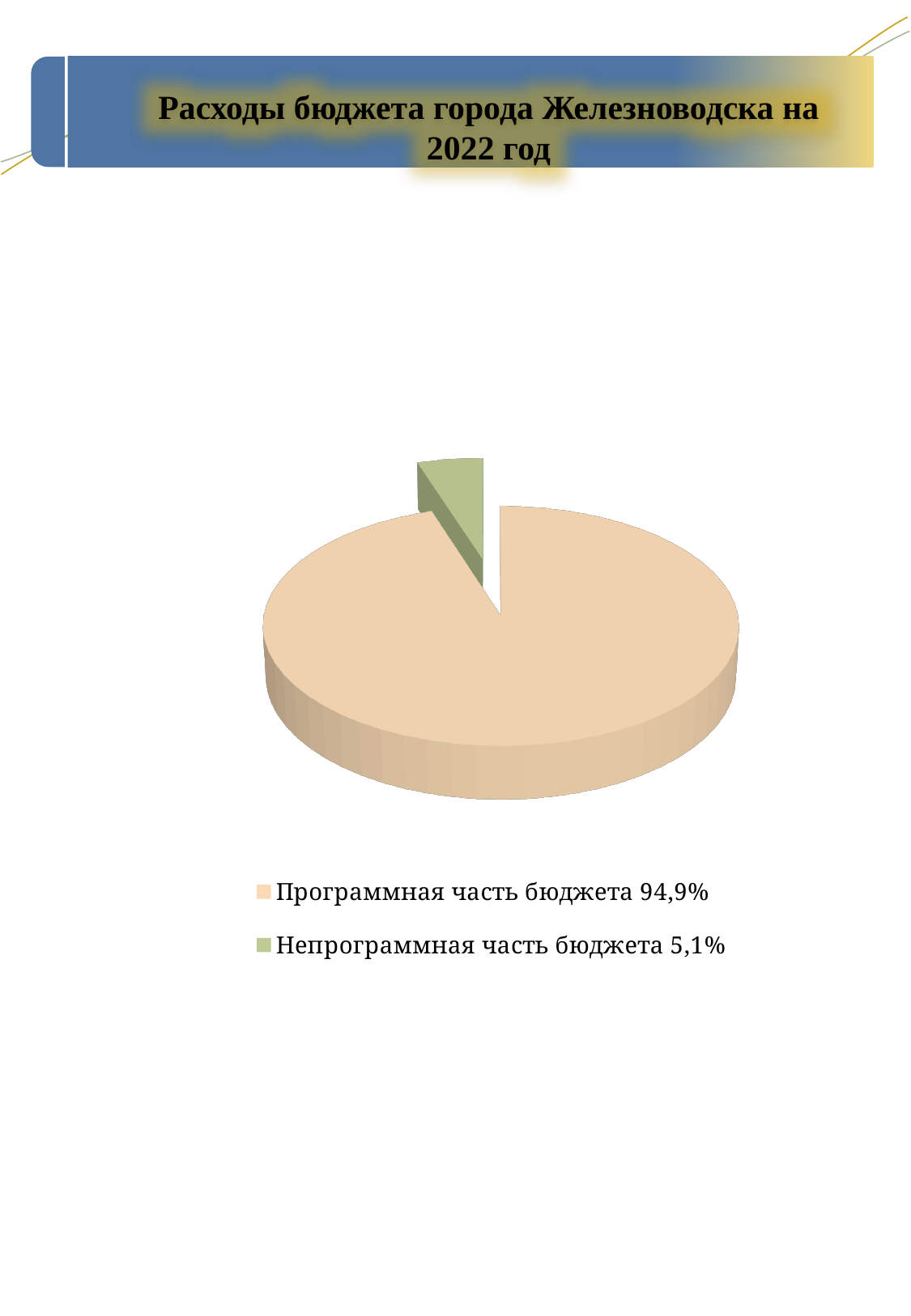
What is the title of the slide containing the pie chart? Расходы бюджета города Железноводска на 2022 год What share of the pie is Программная часть бюджета? 94,9% How many entries does the legend list? 2 What share of the pie is Непрограммная часть бюджета? 5,1% How many slices does the pie chart have? 2 What is the difference in percentage points between Программная часть бюджета and Непрограммная часть бюджета? 89,8 Which slice is the smallest in the pie chart? Непрограммная часть бюджета Which slice is the largest in the pie chart? Программная часть бюджета Which is larger: Программная часть бюджета or Непрограммная часть бюджета? Программная часть бюджета What colour is the slice for Непрограммная часть бюджета? Green What kind of chart is shown on the slide? Pie chart